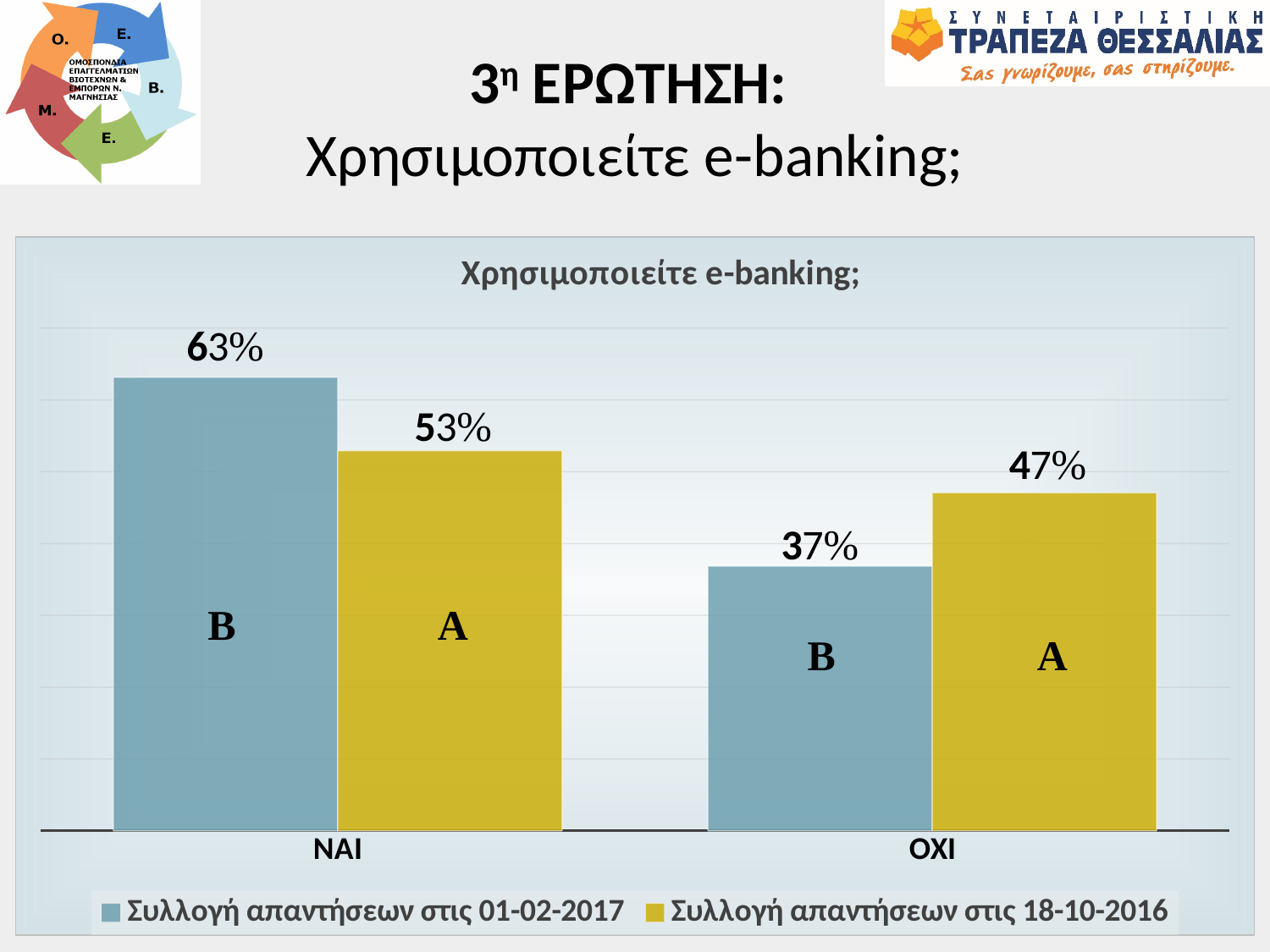
What is the difference between the ΝΑΙ values of the two series? 10% Which bar has the highest value on the chart? ΝΑΙ, Συλλογή απαντήσεων στις 01-02-2017 What kind of chart is shown on the slide? Bar chart For ΟΧΙ, which series has the larger value? Συλλογή απαντήσεων στις 18-10-2016 What is the value for ΟΧΙ in the series 'Συλλογή απαντήσεων στις 01-02-2017'? 37% Which bar has the lowest value on the chart? ΟΧΙ, Συλλογή απαντήσεων στις 01-02-2017 How many categories are shown on the x axis? 2 What is the difference between the ΟΧΙ values of the two series? 10% What is the value for ΟΧΙ in the series 'Συλλογή απαντήσεων στις 18-10-2016'? 47% What is the value for ΝΑΙ in the series 'Συλλογή απαντήσεων στις 01-02-2017'? 63% What is the value for ΝΑΙ in the series 'Συλλογή απαντήσεων στις 18-10-2016'? 53% How many series does the legend list? 2